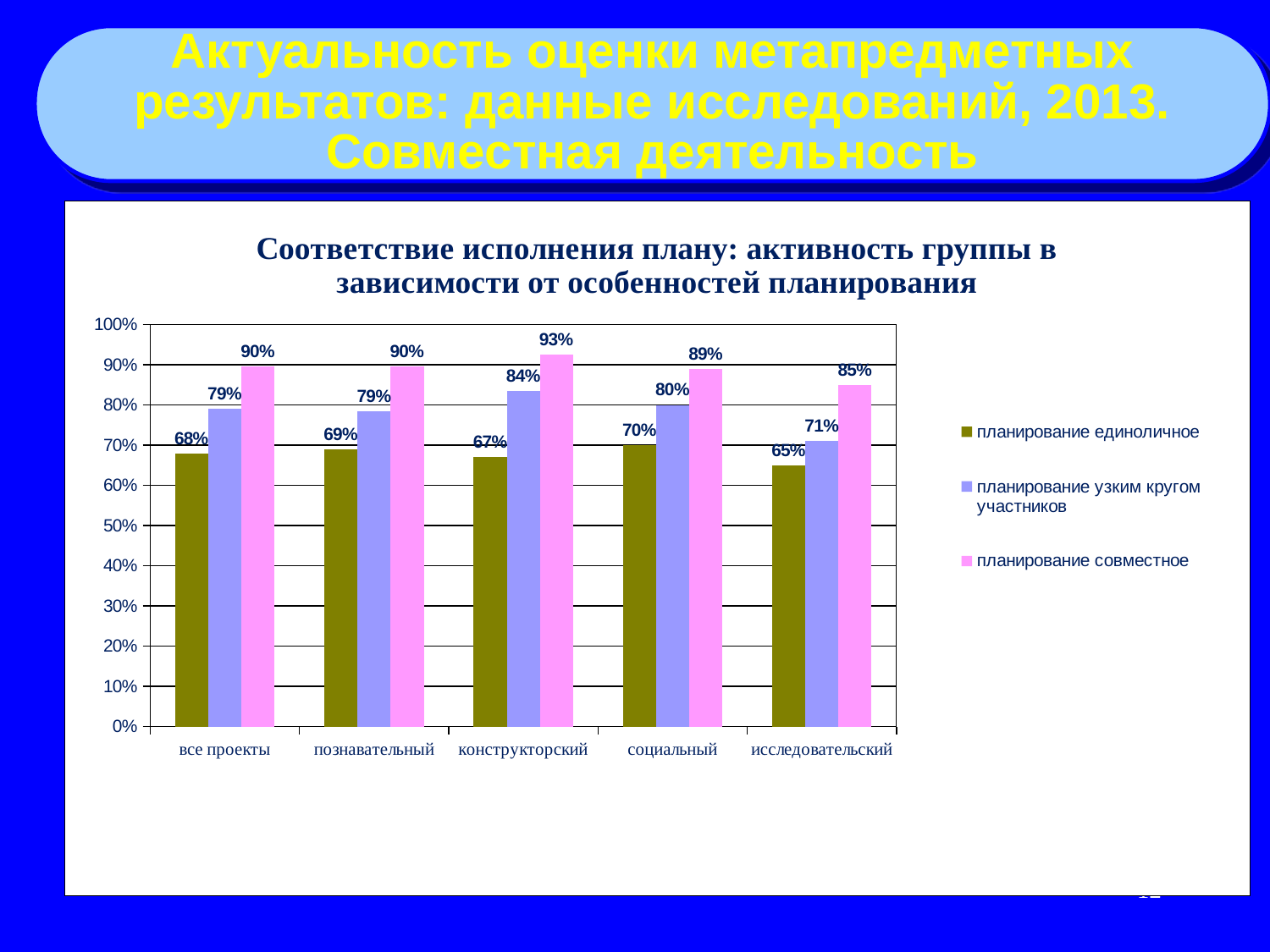
Which is larger in the 'исследовательский' category: 'планирование узким кругом участников' or 'планирование совместное'? планирование совместное Which category has the lowest value for 'планирование единоличное'? исследовательский How many series does the legend list? 3 What is the value for 'планирование узким кругом участников' in the 'социальный' category? 80% What is the value for 'планирование совместное' in the 'конструкторский' category? 93% Which series is shown in pink? планирование совместное How many categories are shown on the x axis? 5 What is the difference between 'планирование совместное' and 'планирование единоличное' in the 'все проекты' category? 22% Which category has the highest value for 'планирование совместное'? конструкторский What is the value for 'планирование единоличное' in the 'исследовательский' category? 65% What kind of chart is shown on the slide? bar chart What is the value for 'планирование узким кругом участников' in the 'конструкторский' category? 84%